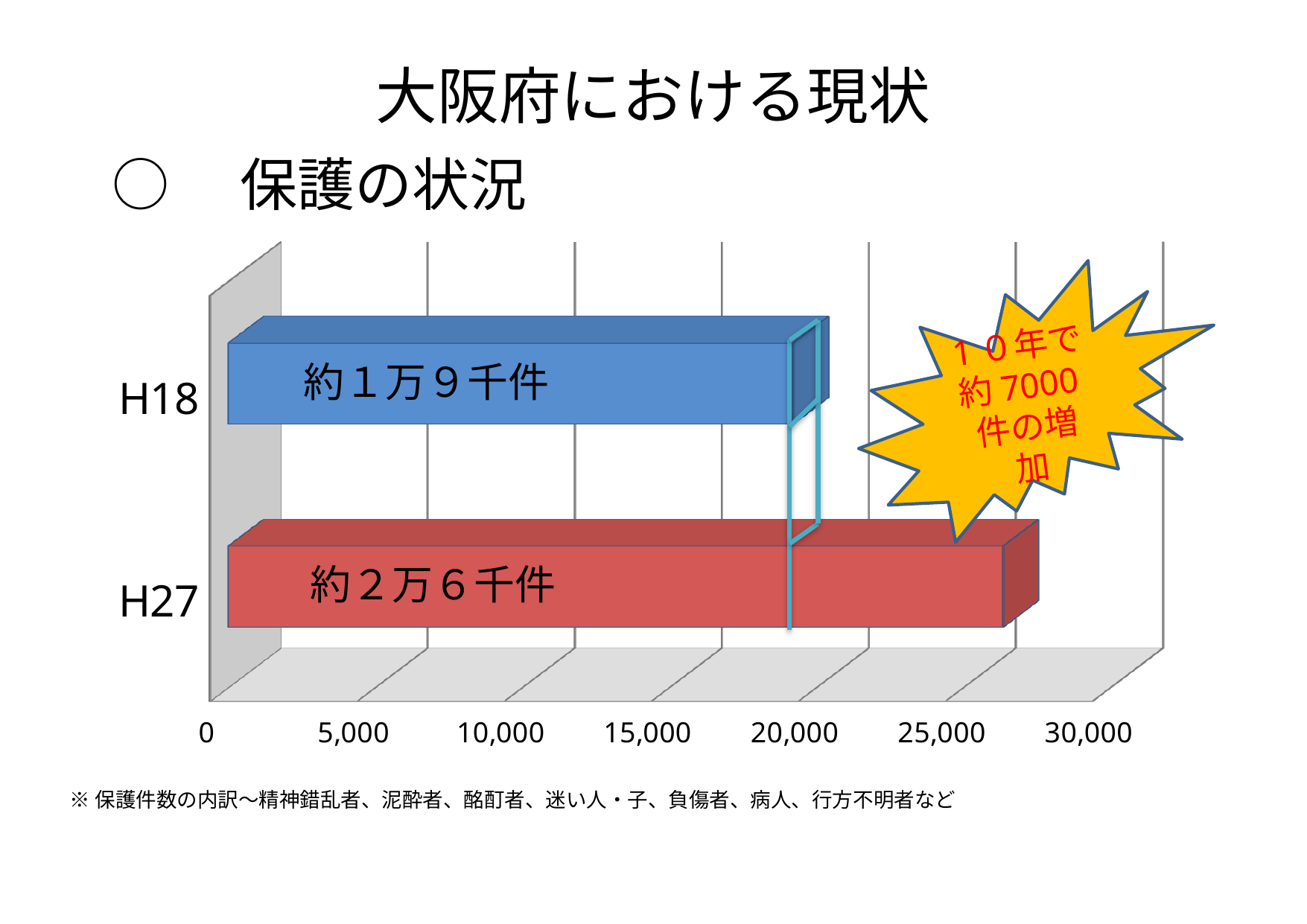
Is the value for H27 larger or smaller than the value for H18? larger How many categories (bars) does the chart show? 2 Is the value for H18 greater or less than 20,000? less Which category has the highest value, H18 or H27? H27 What colour is the H27 bar? red Is the value for H18 greater or less than 15,000? greater Is the value for H27 greater or less than 25,000? greater What text label is printed on the H27 bar? 約２万６千件 What kind of chart is shown on the slide? bar chart What text label is printed on the H18 bar? 約１万９千件 Which category has the lowest value? H18